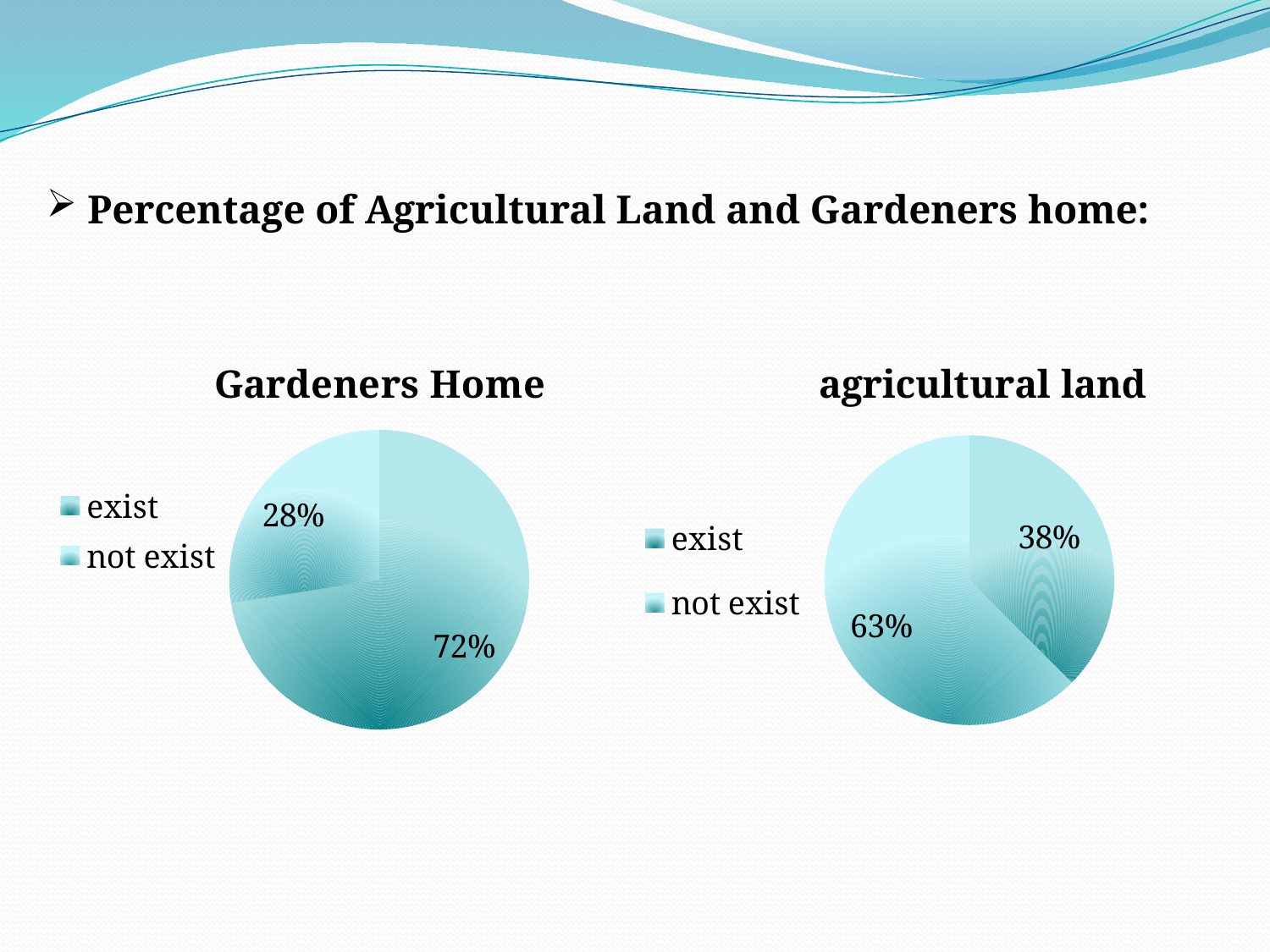
In the Gardeners Home chart, what percentage is shown for 'not exist'? 28% Which is larger: the 'exist' share in the Gardeners Home chart or the 'exist' share in the agricultural land chart? Gardeners Home How many slices does the agricultural land pie chart have? 2 In the agricultural land chart, what percentage is shown for 'exist'? 38% How many entries does the legend of the Gardeners Home chart list? 2 In the agricultural land chart, what percentage is shown for 'not exist'? 63% In the Gardeners Home chart, which slice is the largest? exist In the agricultural land chart, what is the difference between the 'not exist' and 'exist' percentages? 25% In the Gardeners Home chart, what percentage is shown for 'exist'? 72% In the agricultural land chart, which slice is the smallest? exist What kind of chart is the Gardeners Home chart? pie chart In the Gardeners Home chart, what is the difference between the 'exist' and 'not exist' percentages? 44%